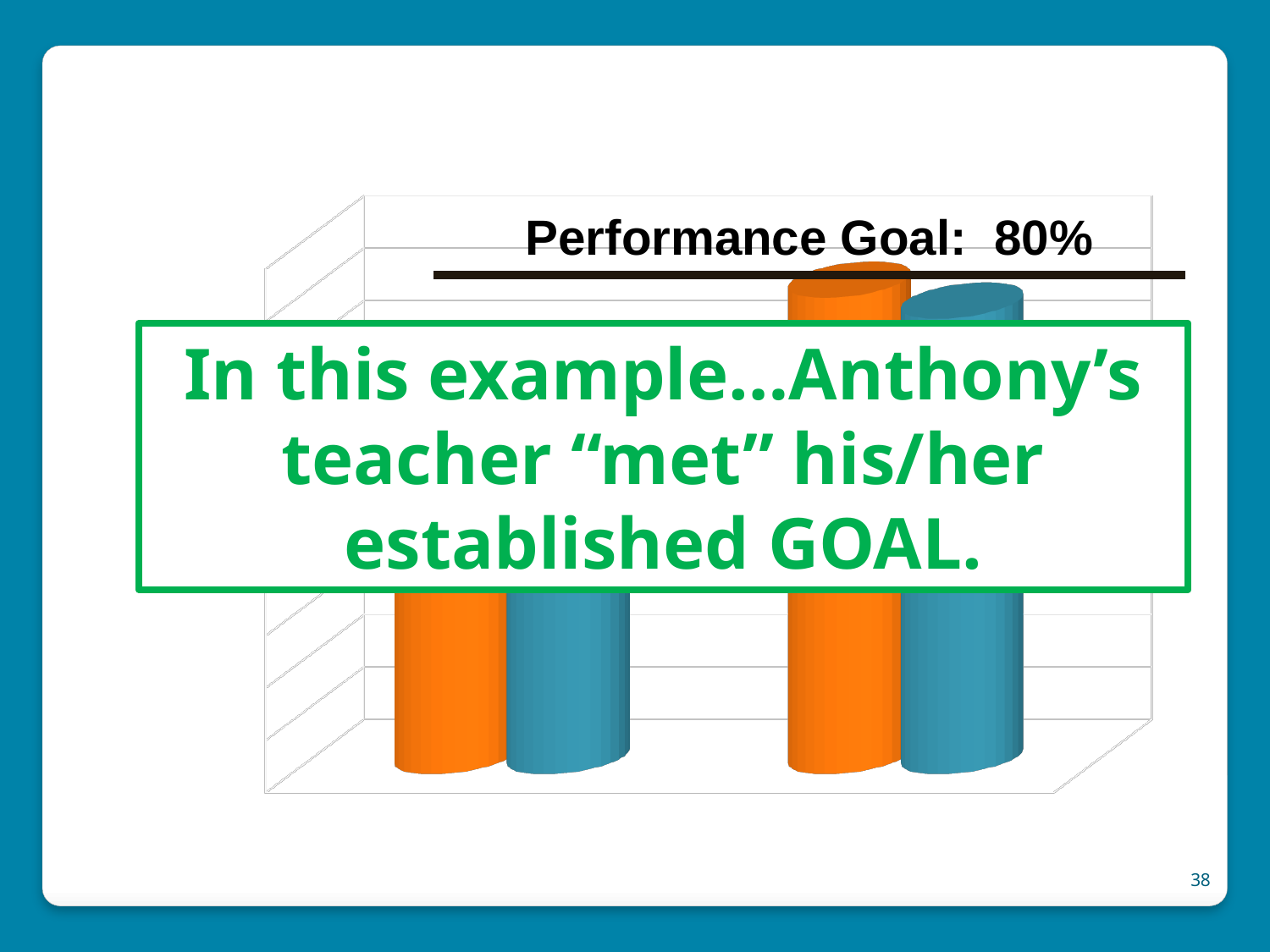
How many bars are plotted in the chart? 4 What two colours are used for the bars in the chart? orange and blue Is the value of the blue bar in the left pair greater or less than the 80% performance goal? less Which orange bar is taller, the one in the left pair or the one in the right pair? the right pair What performance goal is labelled on the horizontal line across the chart? Performance Goal: 80% Do the bar heights rise or fall from the left pair to the right pair? rise Which blue bar is taller, the one in the left pair or the one in the right pair? the right pair Is the value of the orange bar in the right pair greater or less than the 80% performance goal? greater What kind of chart is shown on the slide? bar chart Is the value of the orange bar in the left pair greater or less than the 80% performance goal? less